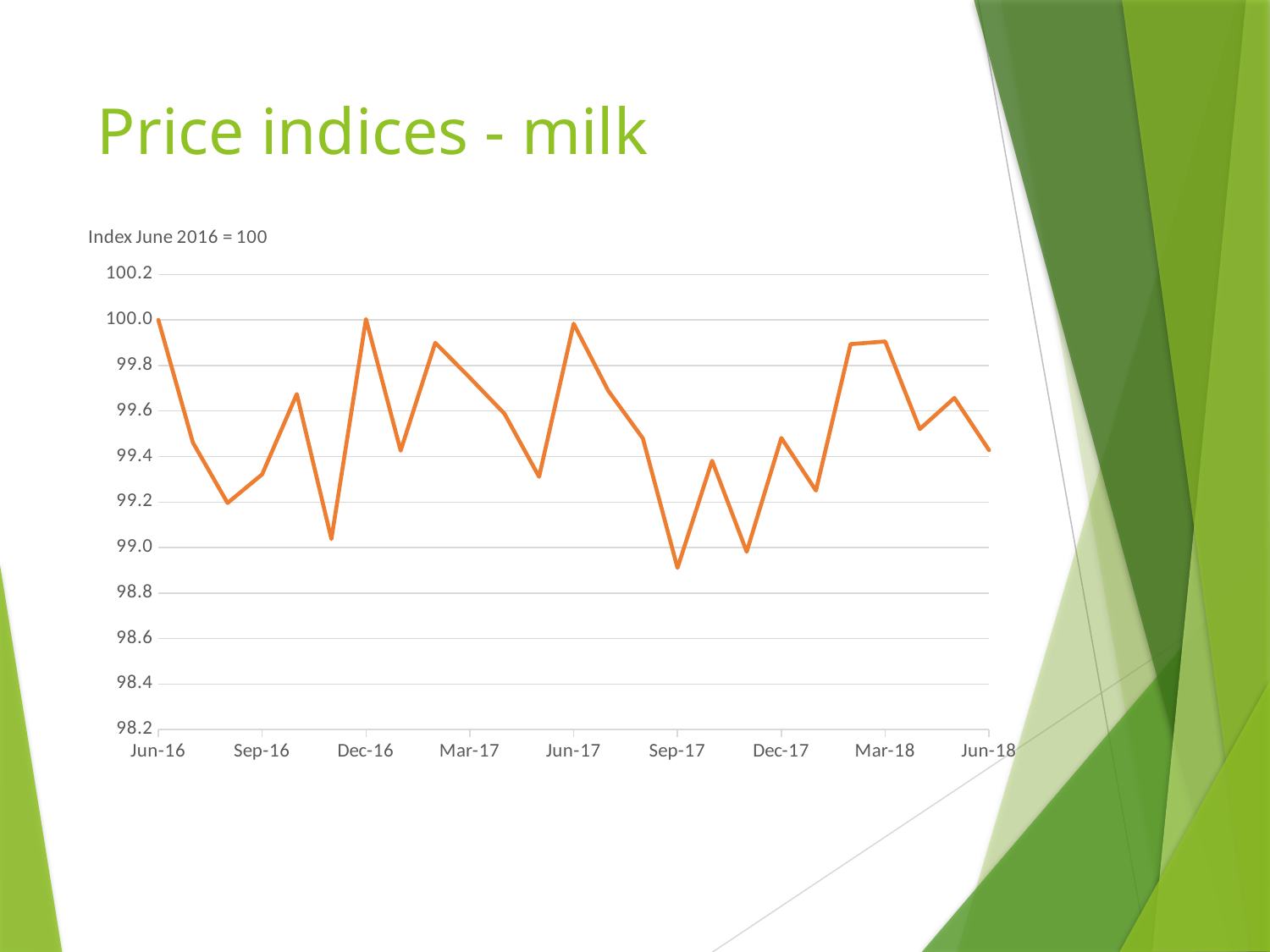
Is the value for Sep-17 greater or less than 99.0? less Which is higher, the value for Jun-17 or the value for Sep-17? Jun-17 Does the index rise or fall from Mar-18 to Jun-18? fall What kind of chart is shown on the slide? line chart Which month has the lowest index value? Sep-17 How many month labels are shown on the x axis? 9 Is the value for Mar-18 greater or less than 99.8? greater What is the title of the slide's chart? Price indices - milk What is the index value for Dec-16? 100.0 What base period does the chart's subtitle say the index is set to 100? June 2016 What is the index value for Jun-16? 100.0 Is the value for Sep-16 greater or less than 99.2? greater